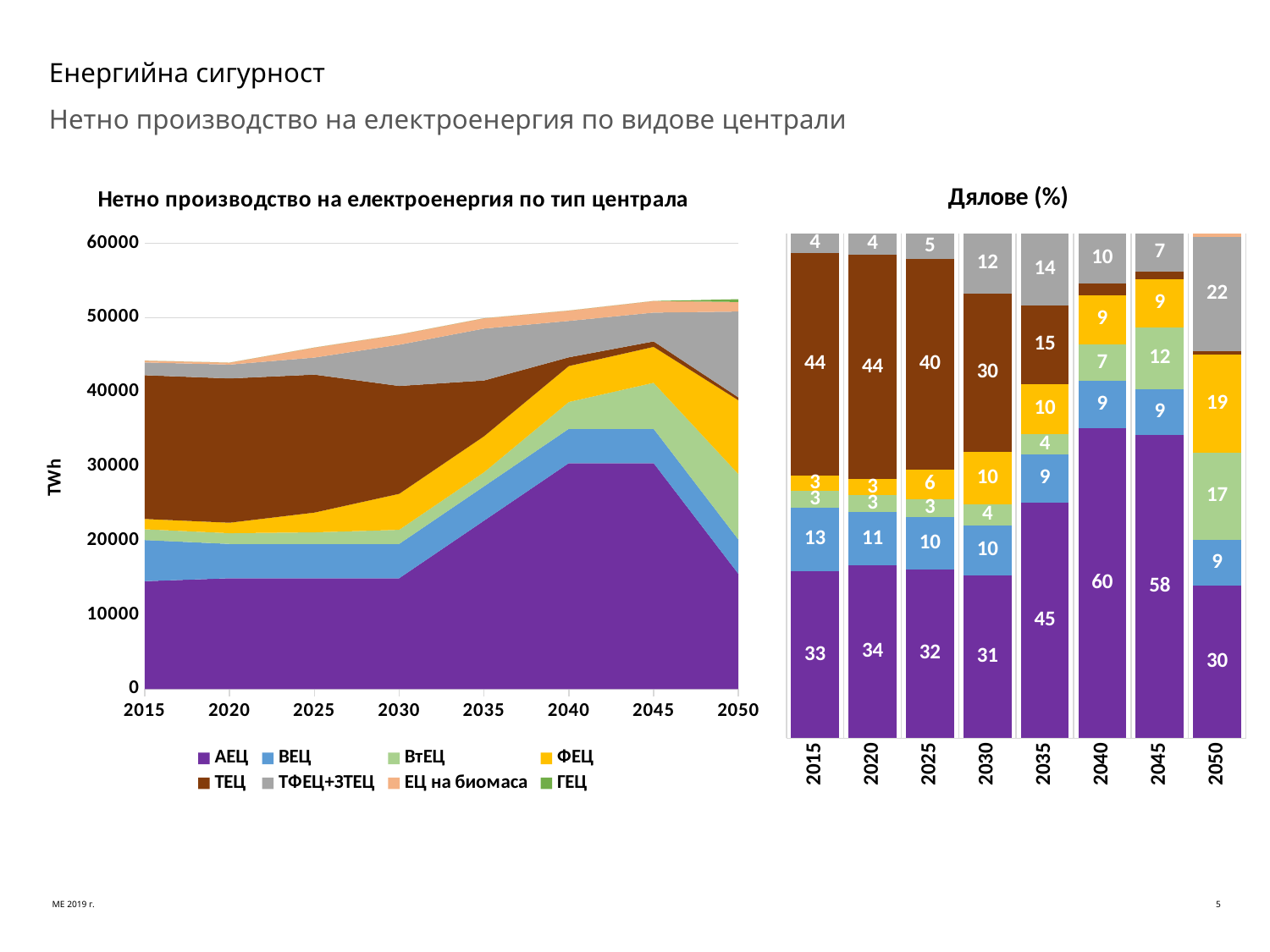
In the chart titled "Дялове (%)", in which year is the share of ФЕЦ highest? 2050 In the chart titled "Дялове (%)", is the share of ТЕЦ larger in 2015 or in 2030? 2015 In the chart titled "Дялове (%)", in which year is the share of АЕЦ highest? 2040 In the left chart, is the value for АЕЦ in 2015 greater or less than 20000? less What kind of chart is the chart titled "Дялове (%)"? Bar chart In the chart titled "Дялове (%)", how many years are shown on the x axis? 8 In the chart titled "Дялове (%)", what is the share of ТФЕЦ+ЗТЕЦ in 2050? 22 What unit is shown on the y axis of the left chart? TWh In the chart titled "Дялове (%)", what is the share of АЕЦ in 2040? 60 In the chart titled "Дялове (%)", what is the difference between the АЕЦ share in 2040 and in 2015? 27 In the chart titled "Дялове (%)", what is the share of ТЕЦ in 2015? 44 How many series does the legend of the left chart list? 8